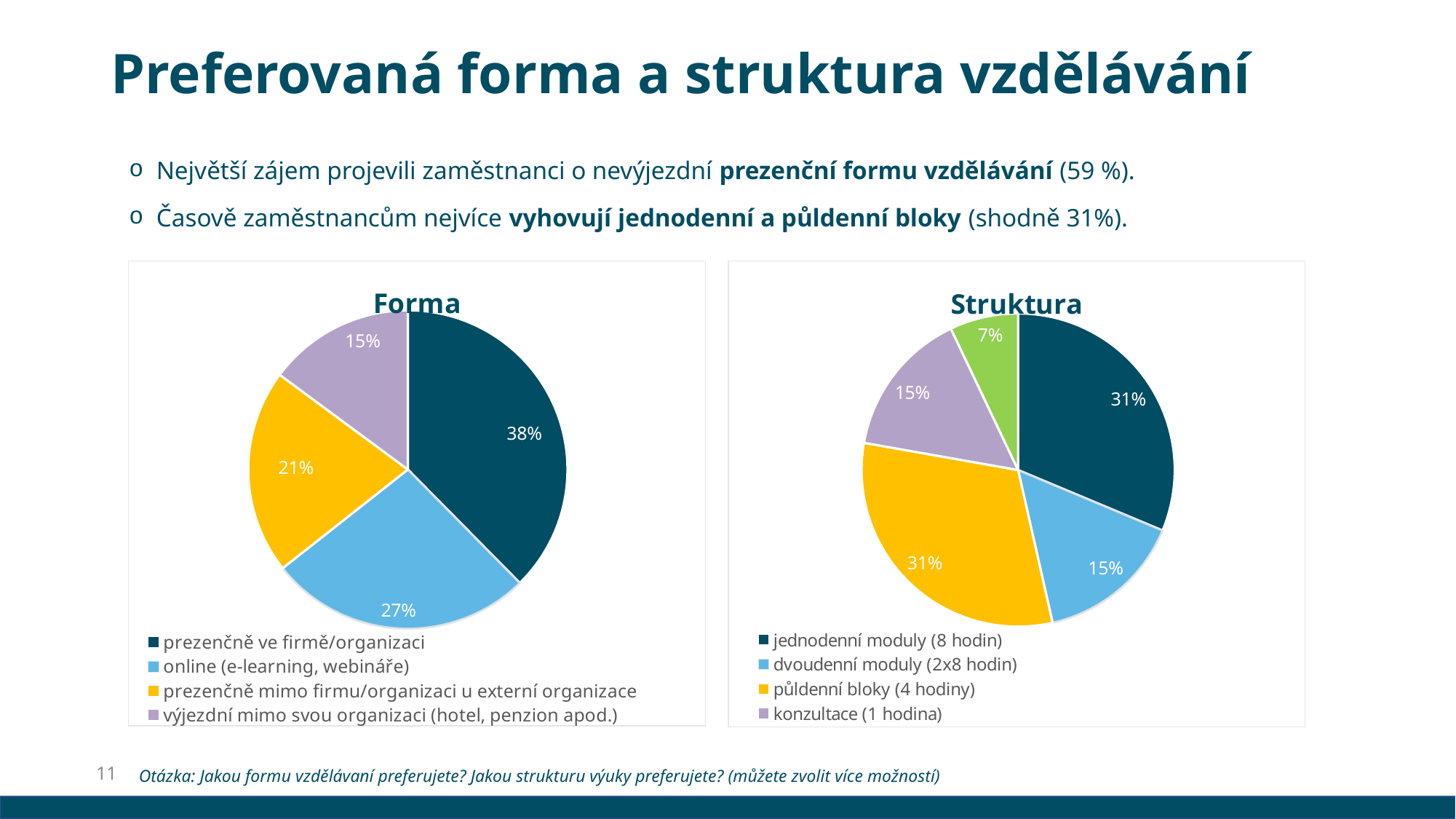
In the "Struktura" chart, what share is shown for "půldenní bloky (4 hodiny)"? 31% In the "Forma" chart, what share is shown for "prezenčně ve firmě/organizaci"? 38% In the "Forma" chart, which category has the largest slice? prezenčně ve firmě/organizaci In the "Struktura" chart, what share is shown for "dvoudenní moduly (2x8 hodin)"? 15% In the "Forma" chart, what colour is the slice for "prezenčně mimo firmu/organizaci u externí organizace"? Yellow What type of chart is the "Struktura" chart? Pie chart In the "Struktura" chart, which is larger: "jednodenní moduly (8 hodin)" or "konzultace (1 hodina)"? jednodenní moduly (8 hodin) In the "Forma" chart, which category has the smallest slice? výjezdní mimo svou organizaci (hotel, penzion apod.) In the "Forma" chart, how many categories does the legend list? 4 In the "Struktura" chart, what is the smallest percentage label shown on any slice? 7% In the "Forma" chart, what share is shown for "online (e-learning, webináře)"? 27% In the "Forma" chart, what is the difference in percentage points between "prezenčně ve firmě/organizaci" and "prezenčně mimo firmu/organizaci u externí organizace"? 17 percentage points